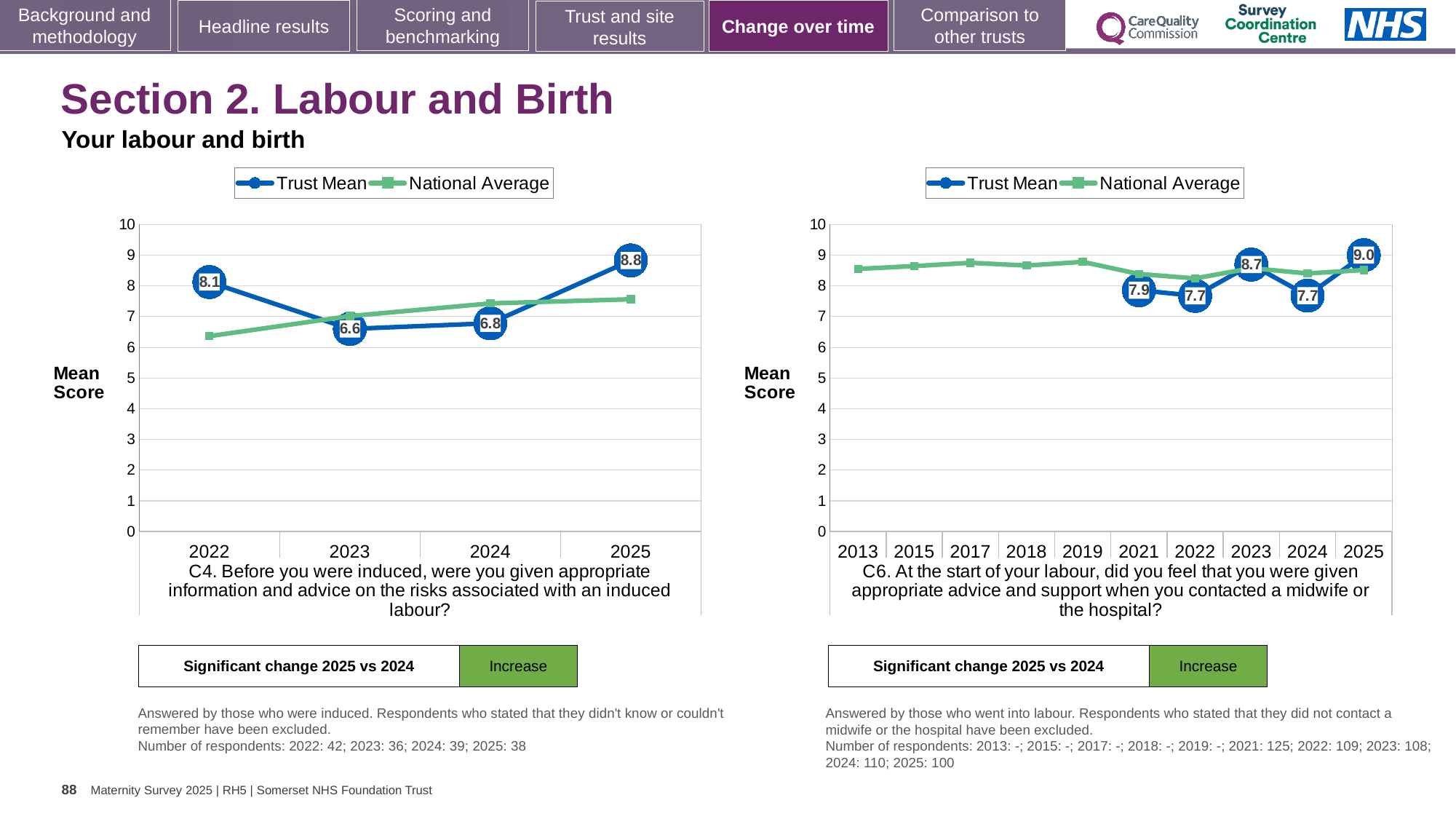
In the left chart (C4), which year has the highest Trust Mean? 2025 In the left chart (C4), is the National Average for 2022 greater or less than 7? less In the right chart (C6), which year has the highest Trust Mean? 2025 In the right chart (C6), is the Trust Mean for 2023 larger or smaller than the Trust Mean for 2024? larger In the right chart (C6), what is the Trust Mean for 2025? 9.0 In the right chart (C6), what is the Trust Mean for 2021? 7.9 How many years are shown on the x axis of the right chart (C6)? 10 In the left chart (C4), what is the Trust Mean for 2025? 8.8 In the left chart (C4), which year has the lowest Trust Mean? 2023 In the left chart (C4), what is the difference between the Trust Mean for 2025 and 2024? 2.0 How many series does the legend of the left chart (C4) list? 2 In the left chart (C4), what is the Trust Mean for 2023? 6.6